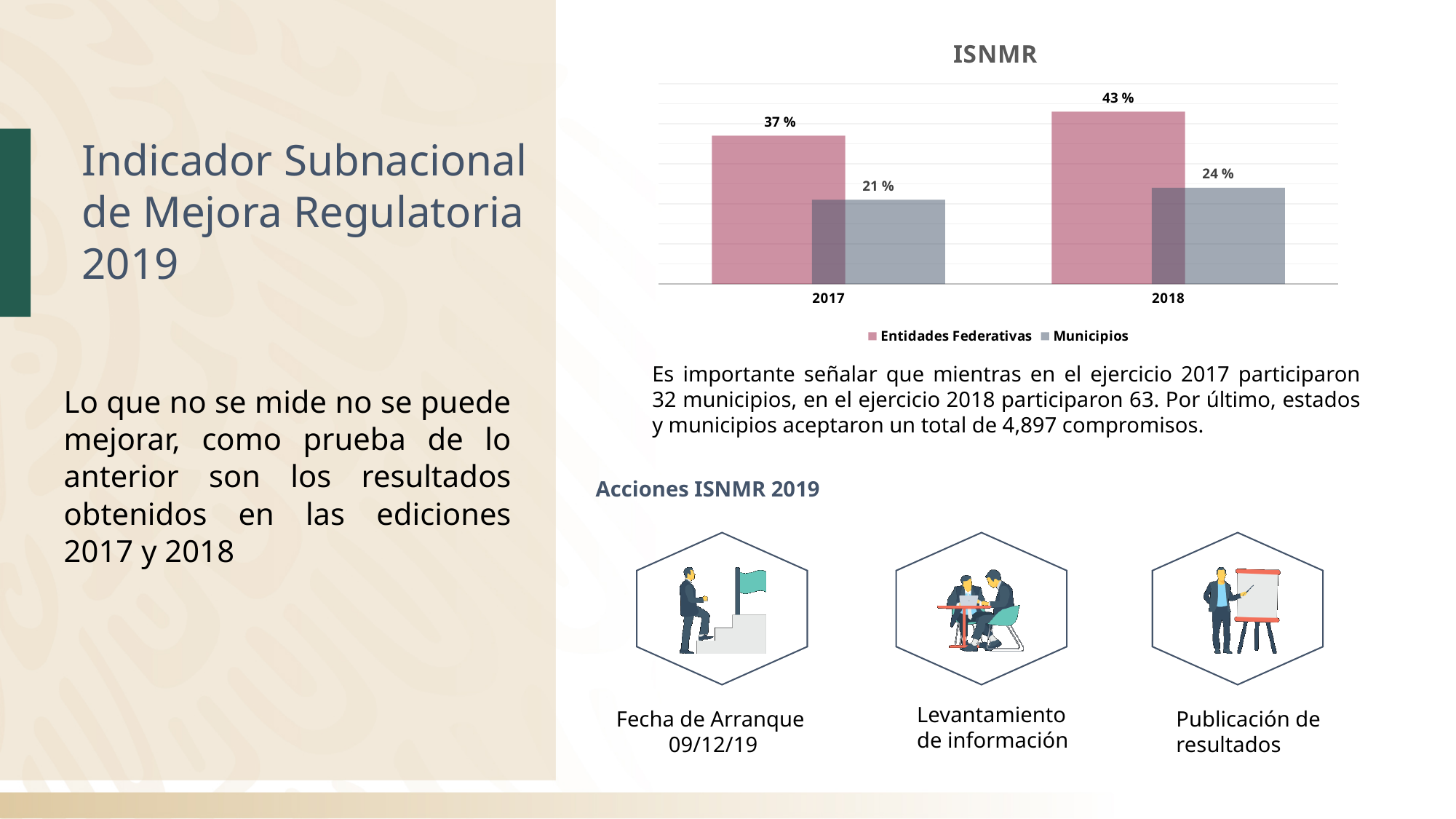
Which year has the lowest value for Municipios? 2017 What is the difference between Entidades Federativas and Municipios in 2018? 19 % Do the Municipios values rise or fall from 2017 to 2018? Rise What is the value for Entidades Federativas in 2017? 37 % What is the difference between the Entidades Federativas values for 2018 and 2017? 6 % Which is larger in 2017, Entidades Federativas or Municipios? Entidades Federativas What is the value for Municipios in 2018? 24 % How many series does the legend list? 2 What kind of chart is shown? Bar chart What is the value for Entidades Federativas in 2018? 43 % What is the value for Municipios in 2017? 21 % Which year has the highest value for Entidades Federativas? 2018